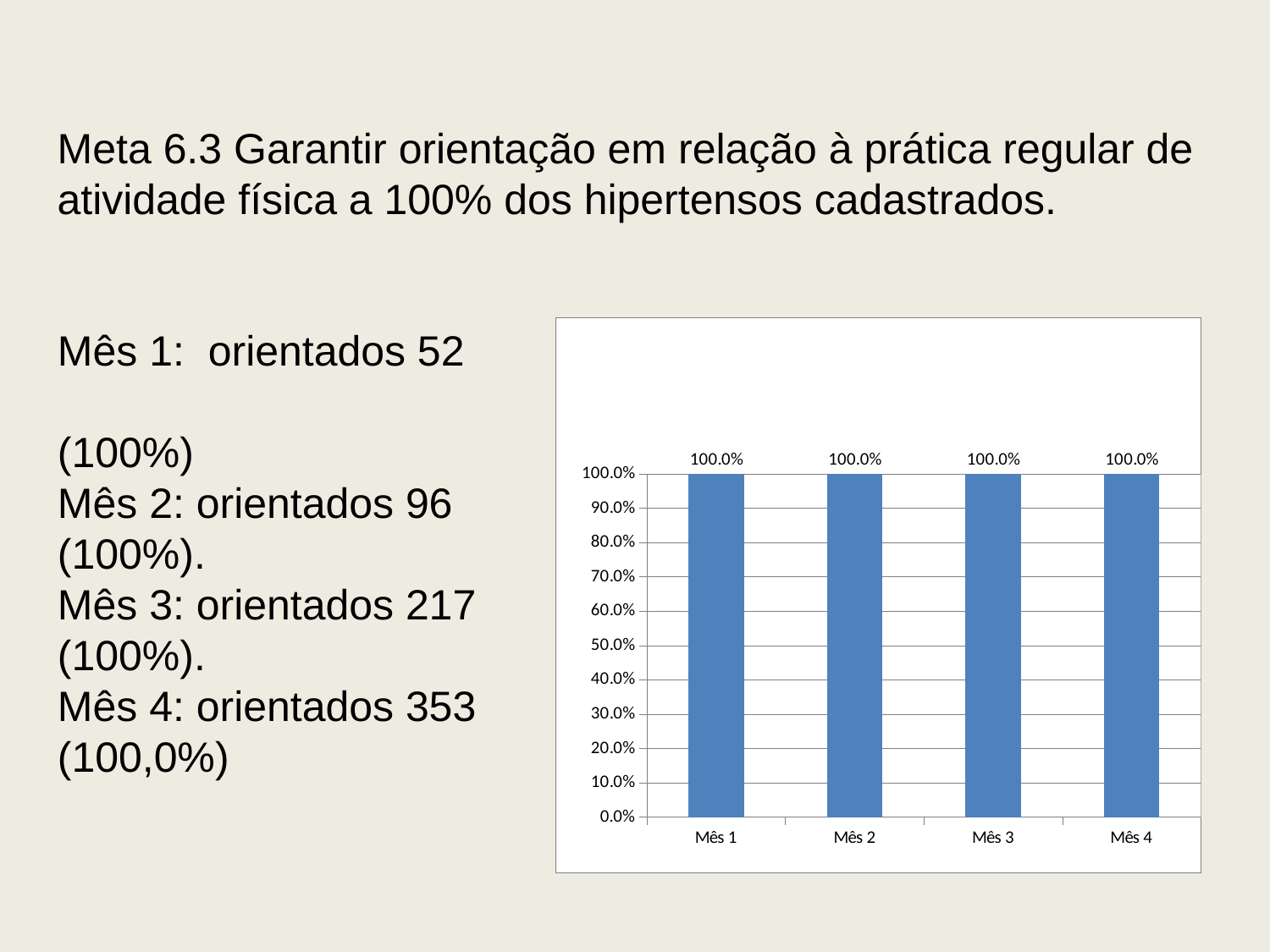
What is the label of the first category on the x axis? Mês 1 What value is shown for Mês 4 in the chart? 100.0% Do the values rise, fall, or stay the same from Mês 1 to Mês 4? Stay the same What value is shown for Mês 3 in the chart? 100.0% What value is shown for Mês 2 in the chart? 100.0% Is the value for Mês 3 greater or less than 50.0%? greater What value is shown for Mês 1 in the chart? 100.0% What is the highest tick value shown on the y axis? 100.0% What kind of chart is shown on the slide? Bar chart How many categories are plotted on the x axis of the chart? 4 What is the difference between the values for Mês 4 and Mês 1? 0.0%